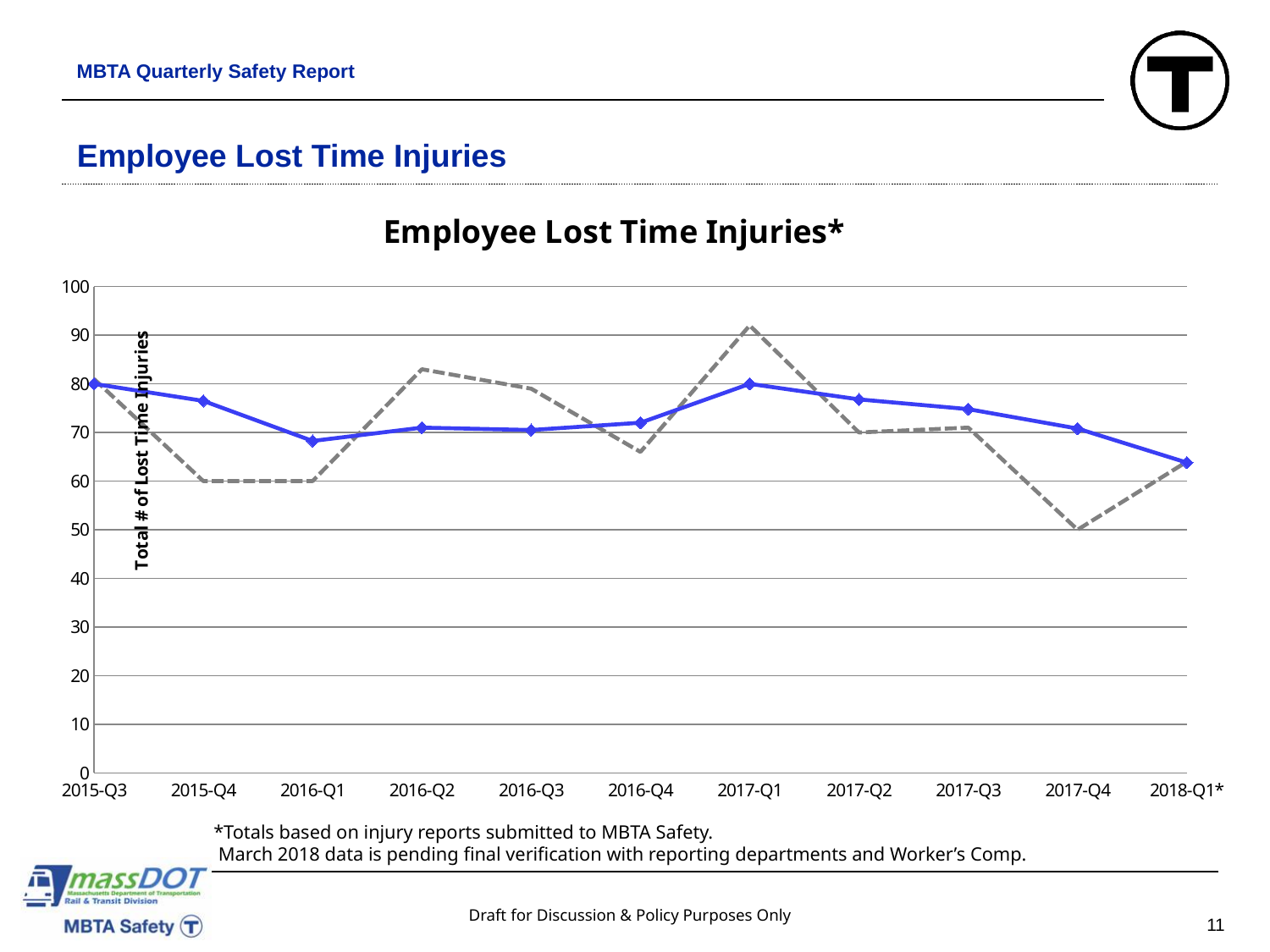
How many quarters are shown along the x axis of the chart? 11 What kind of chart is shown on the slide? Line chart Is the value of the solid blue line for 2018-Q1* greater or less than 70? less What is the label on the vertical axis of the chart? Total # of Lost Time Injuries Is the value of the gray dashed line for 2017-Q1 greater or less than 80? greater At which quarter does the gray dashed line reach its highest value? 2017-Q1 At which quarter does the gray dashed line reach its lowest value? 2017-Q4 Is the value of the solid blue line for 2015-Q4 greater or less than 70? greater On the gray dashed line, which is larger: the value for 2016-Q2 or the value for 2016-Q4? 2016-Q2 What is the title of the chart? Employee Lost Time Injuries*